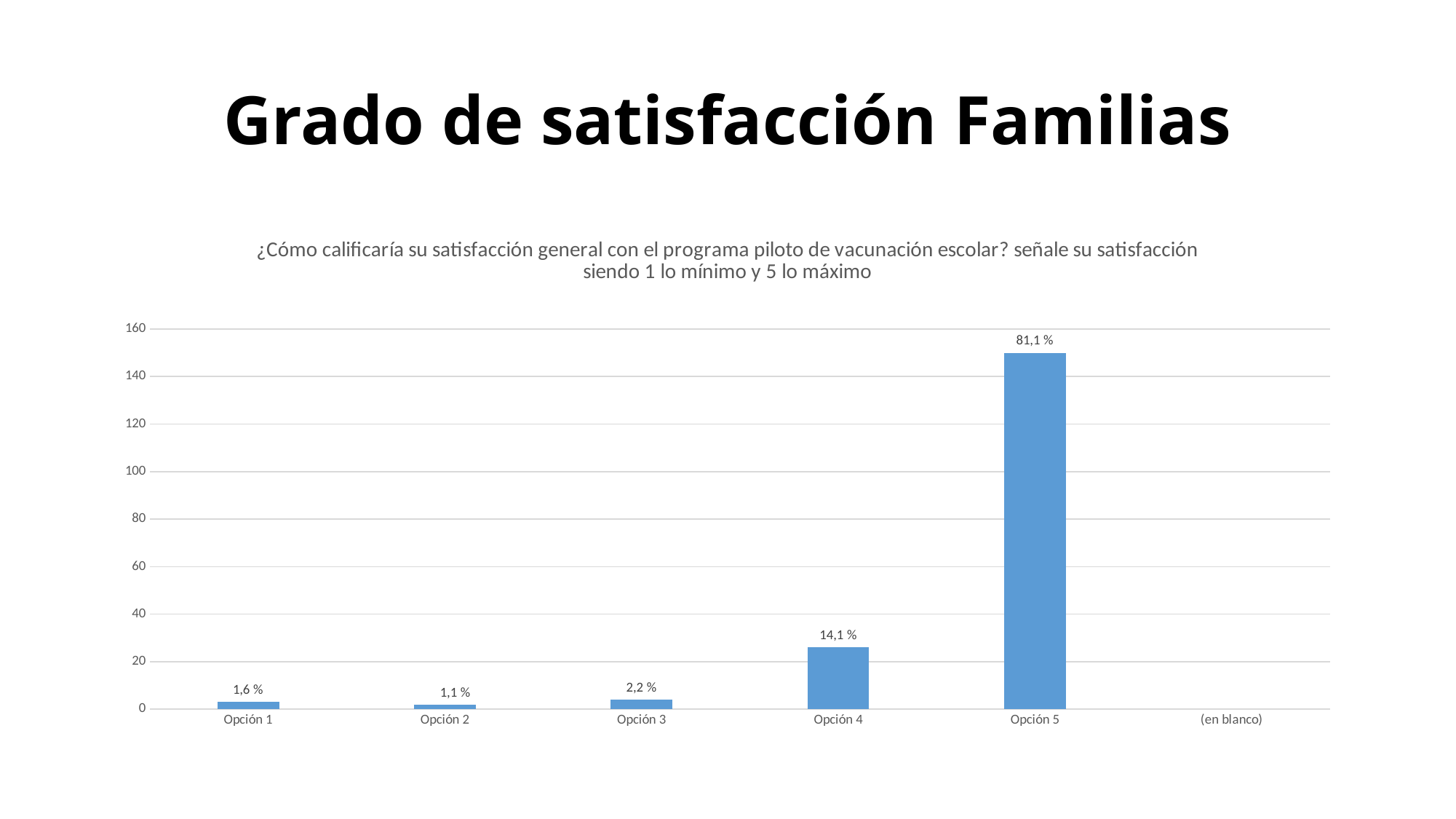
Is the bar for Opción 4 greater or less than 40 on the vertical axis? less What kind of chart is shown on the slide? Bar chart Is the bar for Opción 5 greater or less than 140 on the vertical axis? greater What is the data label shown for Opción 5? 81,1 % Which is larger, the value for Opción 4 or the value for Opción 3? Opción 4 Which category has the highest value? Opción 5 What is the data label shown for Opción 3? 2,2 % What is the data label shown for Opción 1? 1,6 % Among the options with a visible bar, which category has the lowest value? Opción 2 What is the data label shown for Opción 4? 14,1 % How many categories are shown on the horizontal axis? 6 What is the difference between the data labels for Opción 4 and Opción 3? 11,9 %